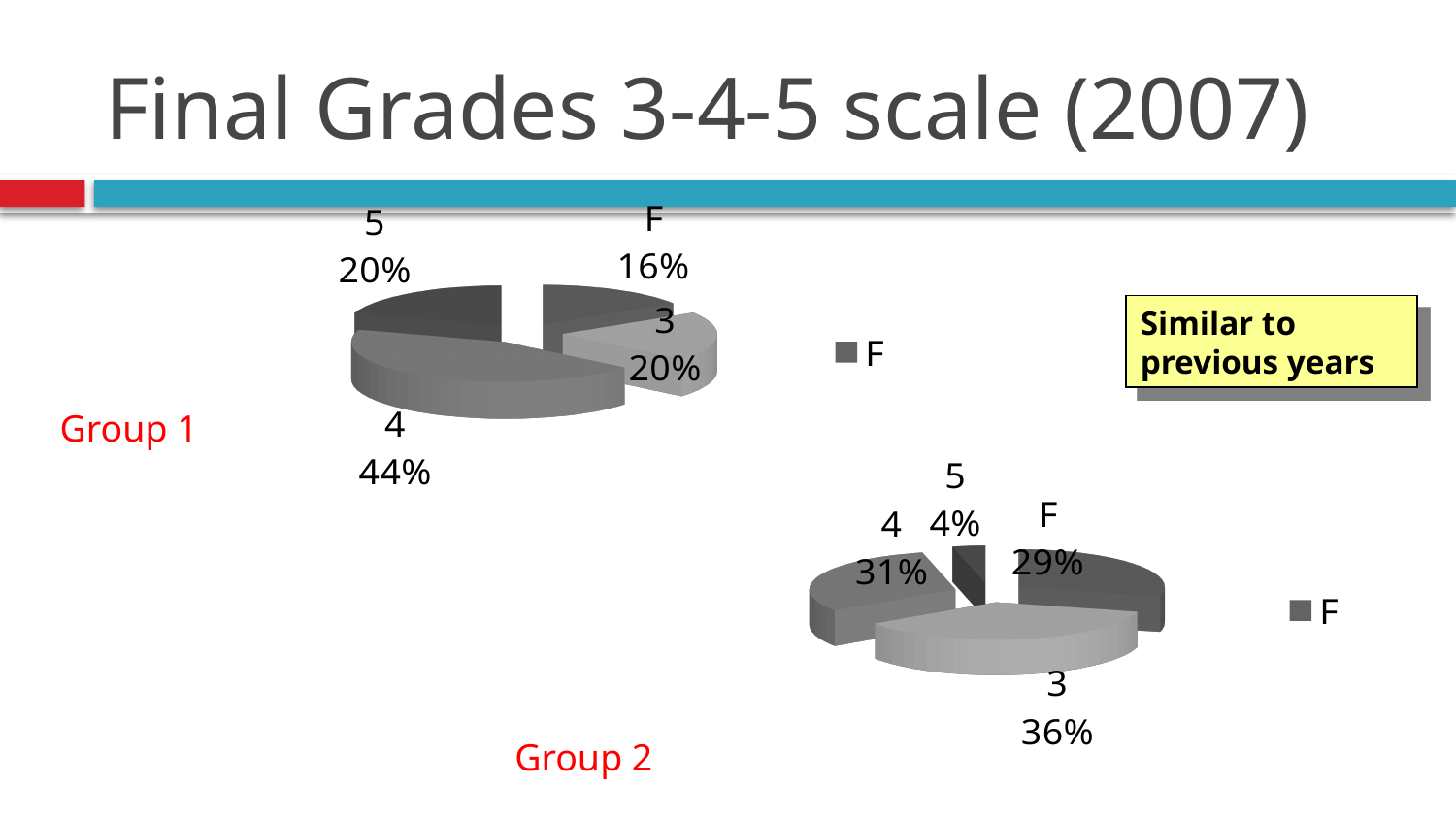
In the Group 2 pie chart, which grade has the largest share? 3 What is the title of the slide containing the two charts? Final Grades 3-4-5 scale (2007) In the Group 2 pie chart, which grade has the smallest share? 5 What type of chart is used for Group 1? Pie chart How many slices does the Group 2 pie chart have? 4 In the Group 1 pie chart, what is the difference in percentage points between grade 4 and grade 3? 24 In the Group 2 pie chart, what share of grades is 5? 4% In the Group 2 pie chart, which is larger, the share for grade 4 or the share for F? 4 In the Group 2 pie chart, what share of grades is 3? 36% In the Group 1 pie chart, what share of grades is 4? 44% In the Group 1 pie chart, what share of grades is F? 16% In the Group 1 pie chart, which grade has the largest share? 4